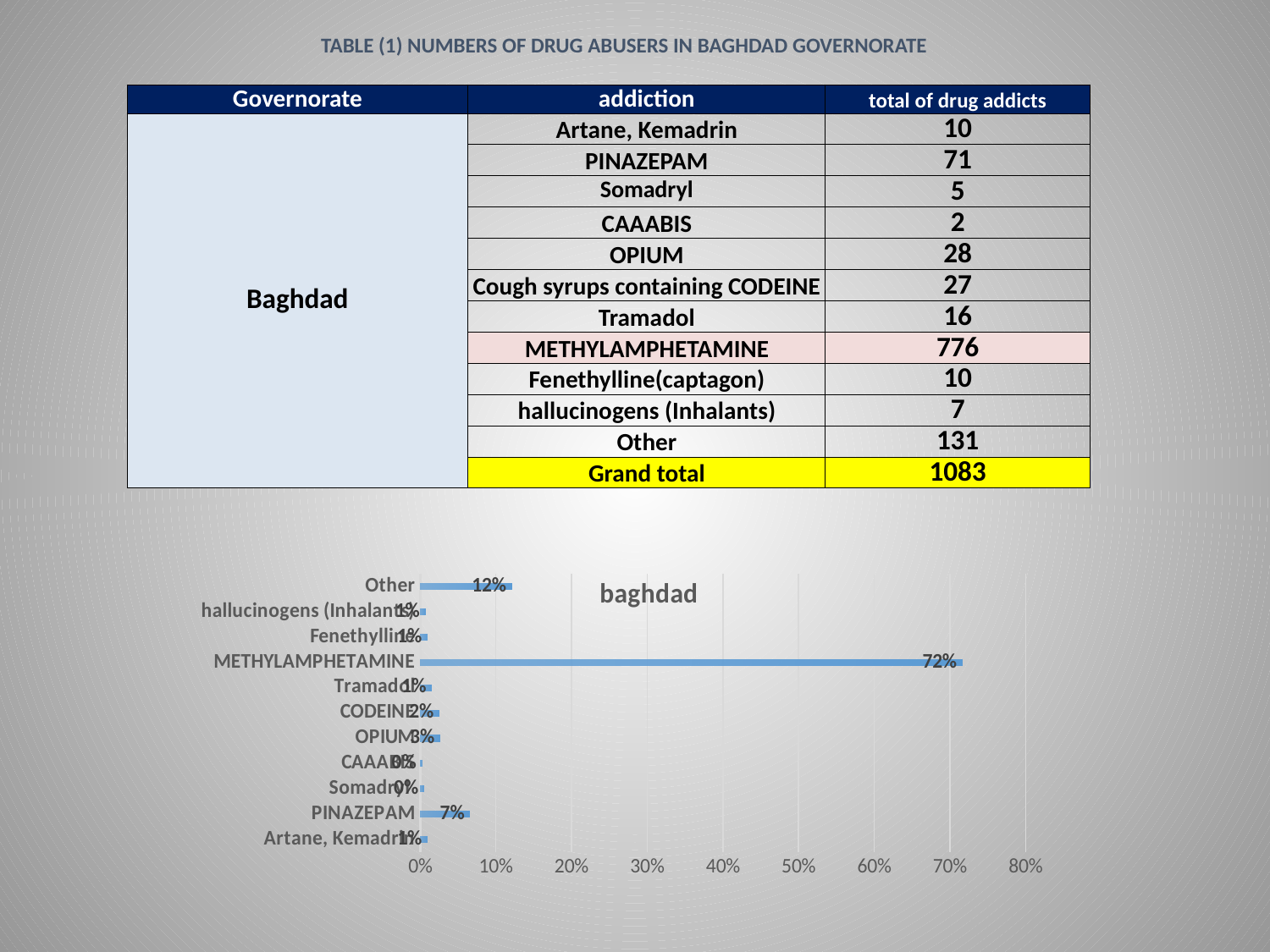
Is the value for METHYLAMPHETAMINE in the chart greater or less than 70%? greater What is the title of the chart? baghdad Which category has the highest value in the chart? METHYLAMPHETAMINE What percentage does the chart show for METHYLAMPHETAMINE? 72% What is the difference between the METHYLAMPHETAMINE and Other percentages in the chart? 60% What percentage does the chart show for OPIUM? 3% What percentage does the chart show for PINAZEPAM? 7% Which is larger in the chart, the value for PINAZEPAM or the value for OPIUM? PINAZEPAM What is the highest value shown on the chart's horizontal axis? 80% How many categories are plotted in the chart? 11 What type of chart is shown on the slide? bar chart What percentage does the chart show for Other? 12%